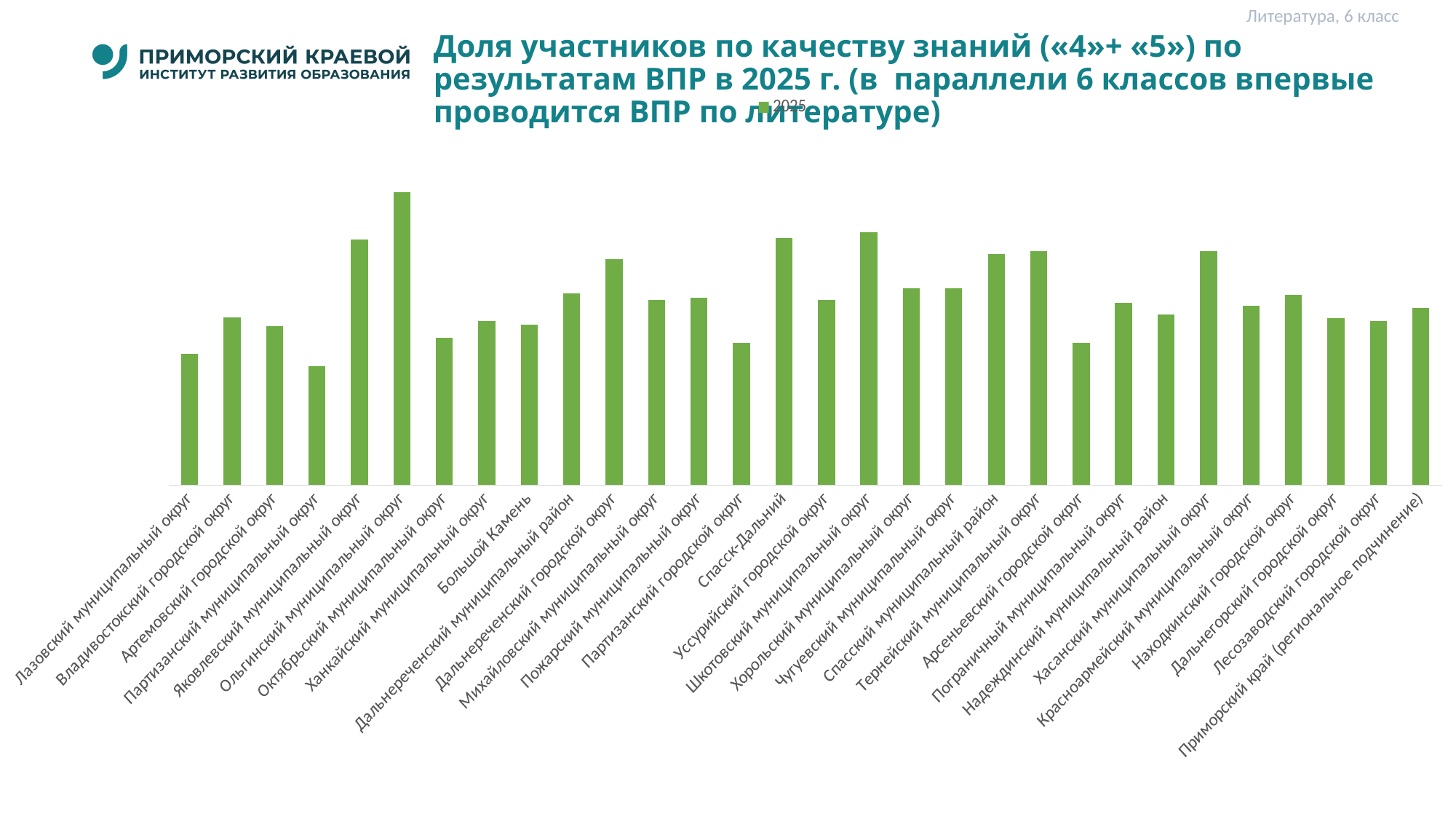
Which is larger: the value for Ольгинский муниципальный округ or for Шкотовский муниципальный округ? Ольгинский муниципальный округ Which is larger: the value for Красноармейский муниципальный округ or for Находкинский городской округ? Находкинский городской округ Which category has the highest value? Ольгинский муниципальный округ How many series does the legend list? 1 Which is larger: the value for Яковлевский муниципальный округ or for Владивостокский городской округ? Яковлевский муниципальный округ What kind of chart is shown on the slide? bar chart What is the legend entry for the series shown? 2025 How many categories (municipalities) are plotted on the x axis? 30 Which category has the lowest value? Партизанский муниципальный округ What subject and grade are indicated in the top-right corner of the slide? Литература, 6 класс